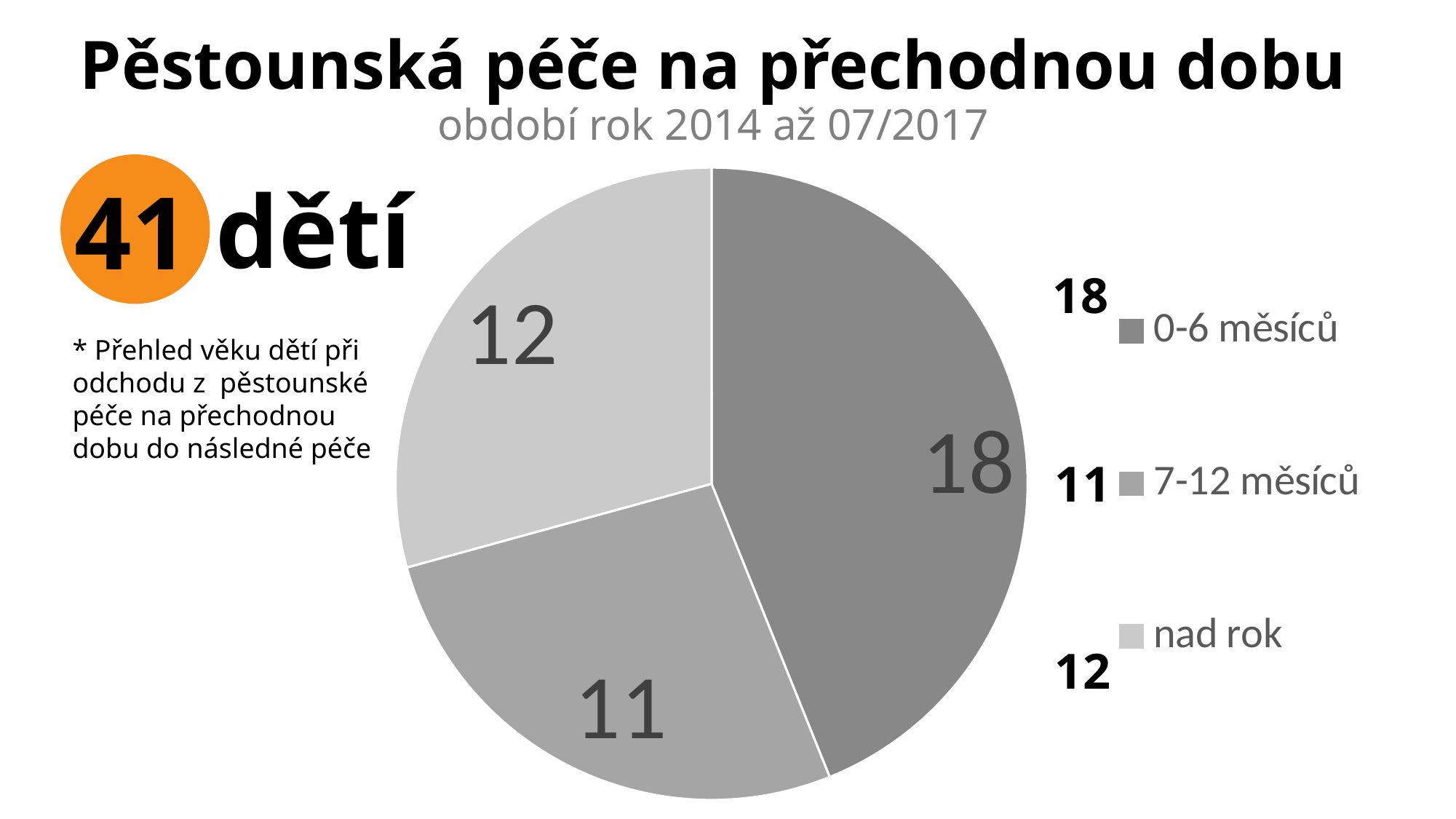
Which is larger, the value for "nad rok" or the value for "7-12 měsíců"? nad rok What is the value for the "0-6 měsíců" slice? 18 Which category has the smallest slice of the pie? 7-12 měsíců Which category has the largest slice of the pie? 0-6 měsíců What is the value for the "nad rok" slice? 12 What kind of chart is shown on the slide? pie chart What is the difference between the values for "0-6 měsíců" and "7-12 měsíců"? 7 What is the value for the "7-12 měsíců" slice? 11 What is the total of all slices in the pie chart? 41 How many slices does the pie chart have? 3 How many entries does the legend list? 3 What period is given in the subtitle of the slide? období rok 2014 až 07/2017